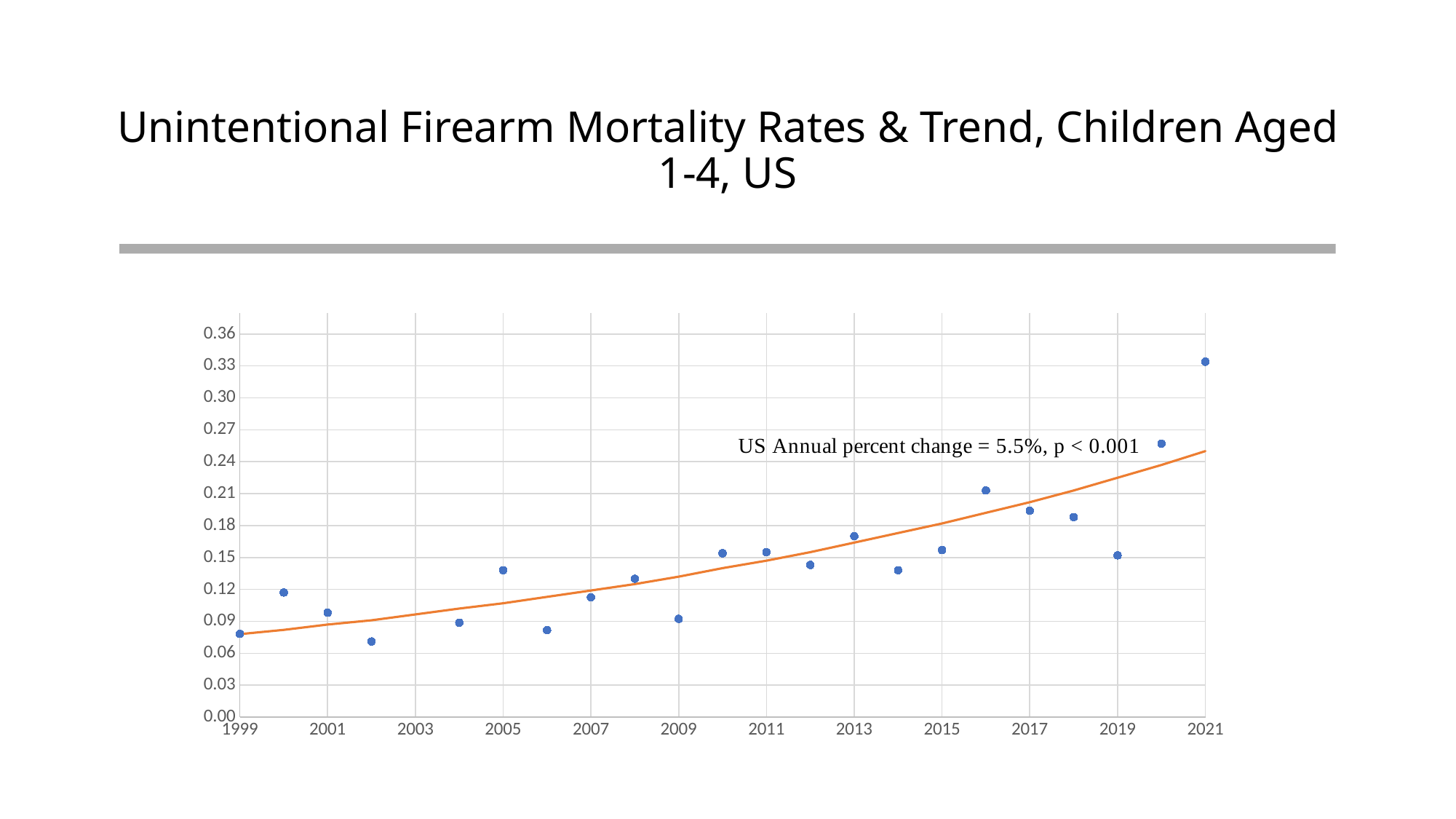
How many data points are plotted in the chart? 22 Which year has the larger value, 2020 or 2019? 2020 What kind of chart is shown on the slide? Scatter plot with a trend line Which year has the lowest unintentional firearm mortality rate in the chart? 2002 Which year has the highest unintentional firearm mortality rate in the chart? 2021 Is the value for 2009 greater or less than 0.12? less Is the value for 2002 greater or less than 0.09? less Is the value for 2021 greater or less than 0.30? greater Which year has the larger value, 2016 or 2014? 2016 What annual percent change is stated in the annotation on the chart? 5.5% Do the values generally rise or fall from 1999 to 2021? Rise